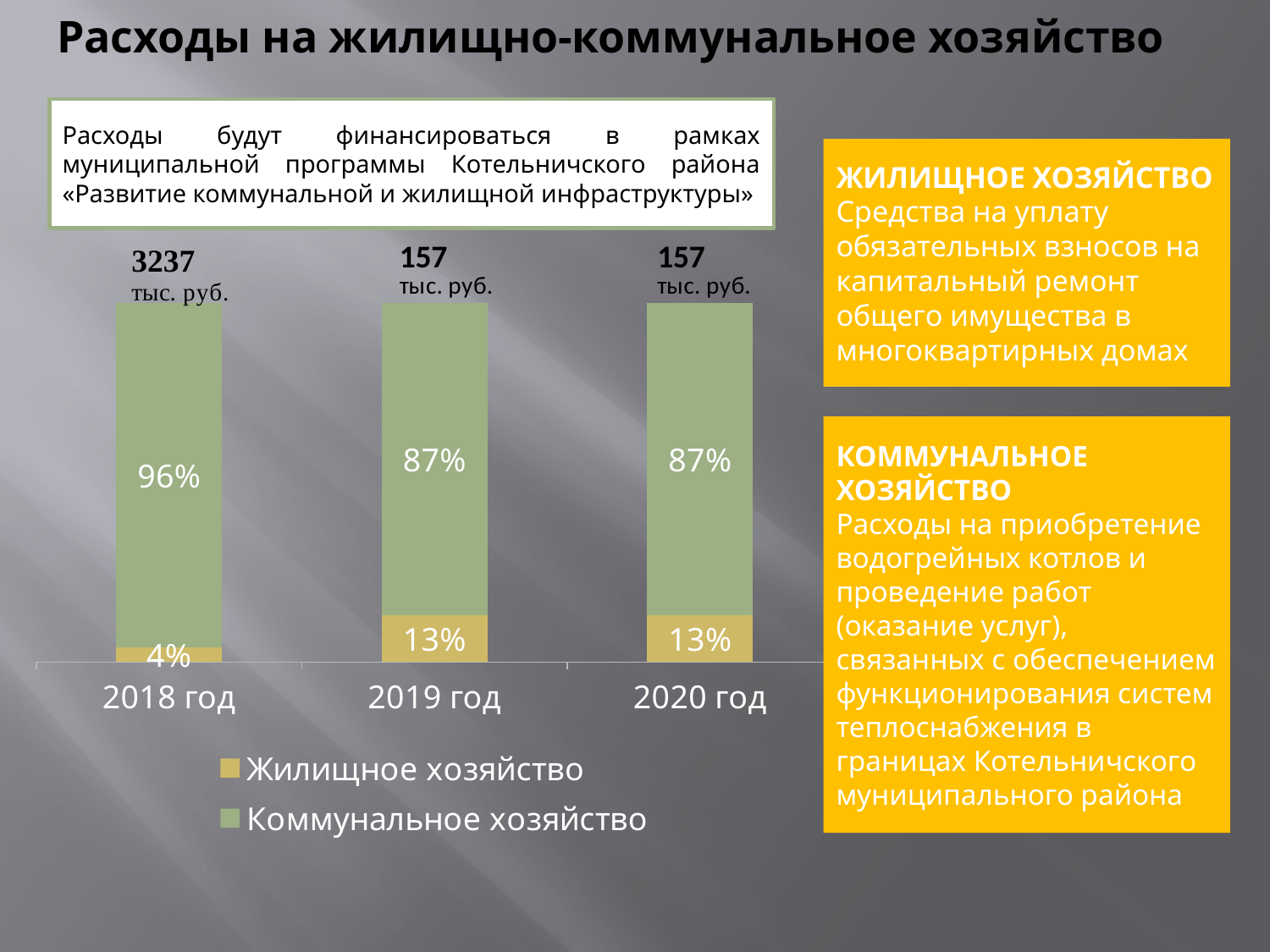
What share does Жилищное хозяйство have in 2018 год? 4% What share does Жилищное хозяйство have in 2019 год? 13% What share does Коммунальное хозяйство have in 2020 год? 87% What is the difference between the Жилищное хозяйство share in 2019 год and in 2018 год? 9% How many series does the chart legend list? 2 What total amount is printed above the bar for 2019 год? 157 тыс. руб. In which year is the share of Жилищное хозяйство the lowest? 2018 год How many years are shown on the x axis of the chart? 3 What share does Коммунальное хозяйство have in 2018 год? 96% In which year is the share of Коммунальное хозяйство the highest? 2018 год What total amount is printed above the bar for 2018 год? 3237 тыс. руб. Which is larger in 2019 год: the share of Жилищное хозяйство or Коммунальное хозяйство? Коммунальное хозяйство